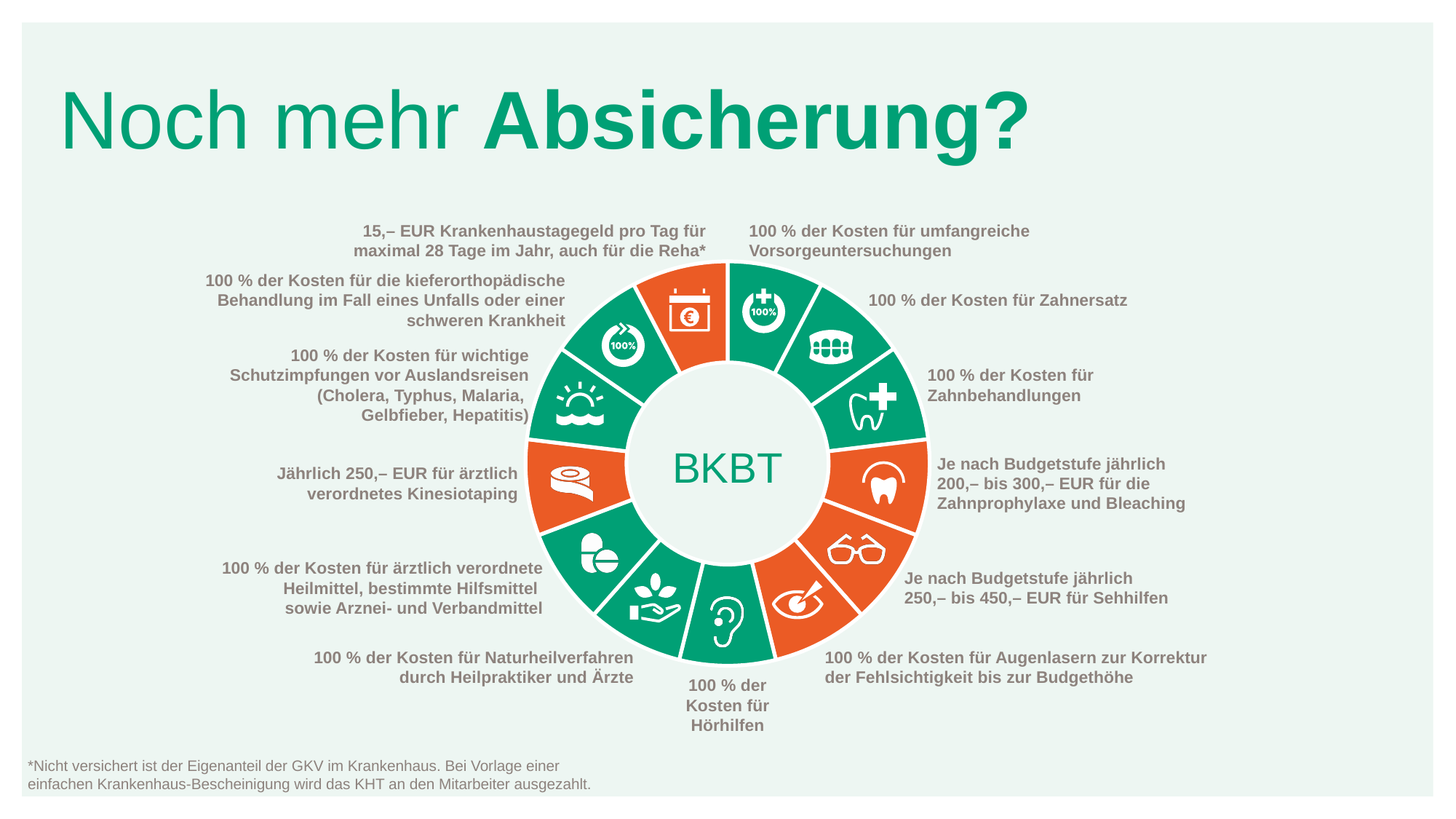
According to the ring diagram, how much Krankenhaustagegeld is paid per day? 15,– EUR What text is shown in the centre of the ring diagram? BKBT Which two colours are used for the segments of the ring diagram? Green and orange What annual amount is listed for ärztlich verordnetes Kinesiotaping? 250,– EUR What share of the costs for Zahnersatz is covered according to the diagram? 100 % How many segments does the ring diagram have? 13 How many segments of the ring are coloured orange? 5 What annual range is given for Sehhilfen depending on the Budgetstufe? 250,– bis 450,– EUR For how many days per year at most is the Krankenhaustagegeld paid? 28 Tage What share of the costs for Hörhilfen is covered according to the diagram? 100 % What annual range is given for Zahnprophylaxe und Bleaching depending on the Budgetstufe? 200,– bis 300,– EUR What kind of chart is shown on the slide? Donut (ring) diagram